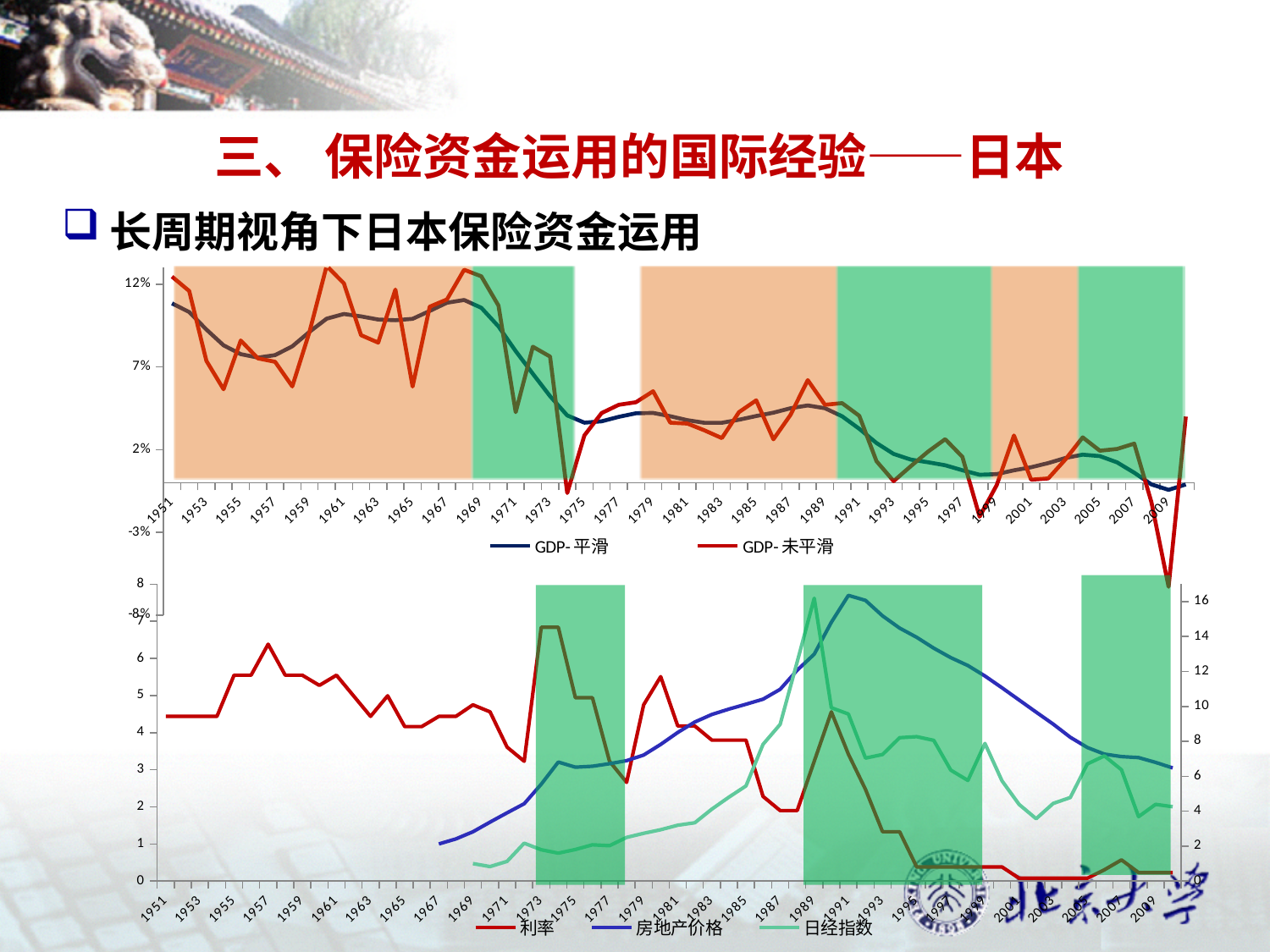
In the top chart, is the value of GDP-未平滑 in 1961 greater or less than 7%? greater In the top chart, is the value of GDP-平滑 in 1951 greater or less than 7%? greater How many series does the legend of the top chart list? 2 What kind of chart is the top chart on the slide? line chart What kind of chart is the bottom chart on the slide? line chart In the top chart, is the value of GDP-未平滑 in 2009 greater or less than 2%? less In the bottom chart, does the 房地产价格 line rise or fall from 1991 to 2009? fall In the top chart, does the GDP-平滑 line overall rise or fall from 1951 to 2009? fall In the bottom chart, what colour is the 利率 line? red How many series does the legend of the bottom chart list? 3